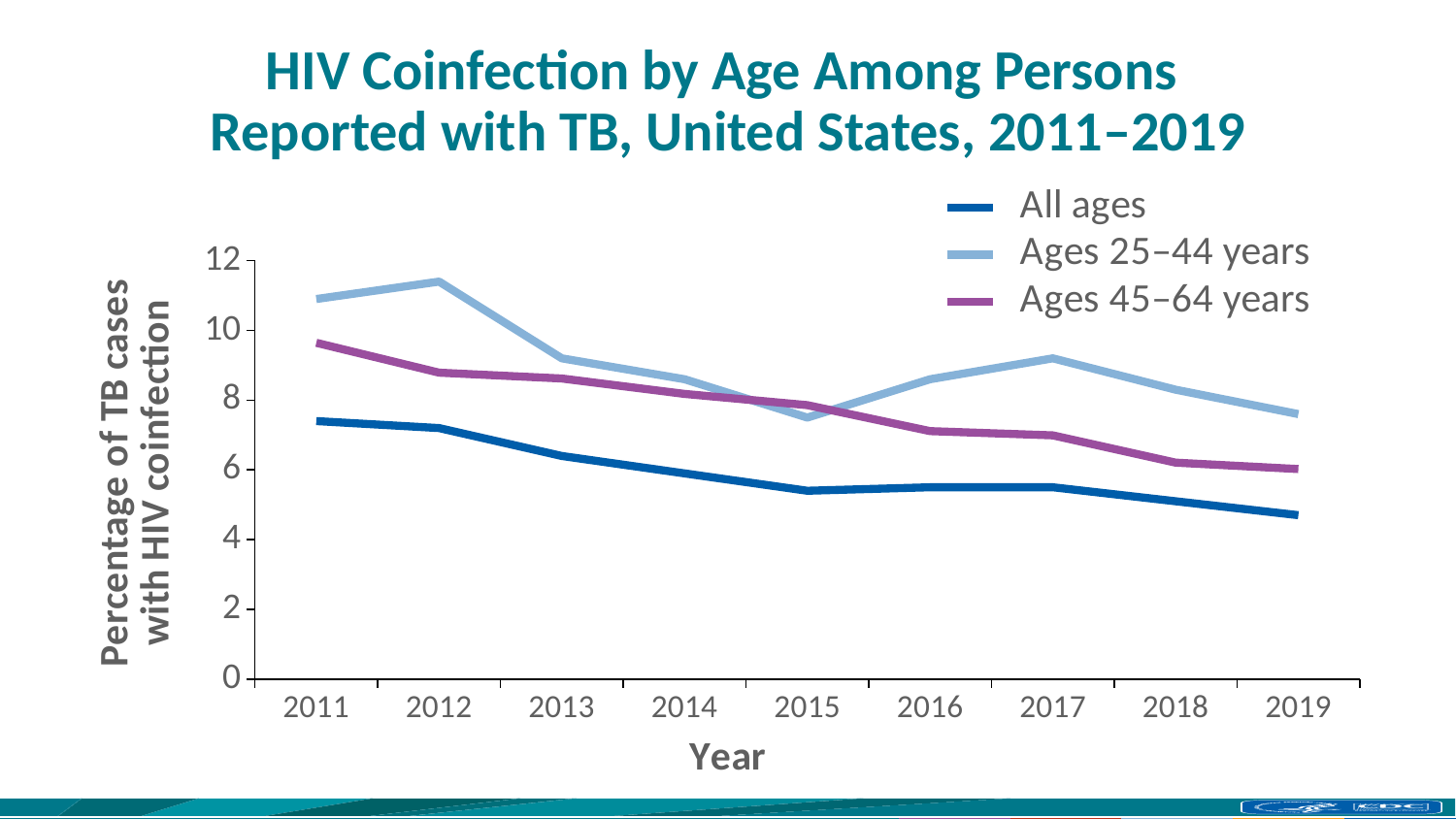
How many series does the legend list? 3 What kind of chart is shown on the slide? Line chart In 2017, which is larger: the value for Ages 25–44 years or Ages 45–64 years? Ages 25–44 years How many years are plotted along the x axis? 9 Is the value for Ages 45–64 years in 2011 greater or less than 8? greater In which year is the All ages series at its lowest? 2019 Is the value for All ages in 2011 greater or less than 6? greater Is the value for All ages in 2019 greater or less than 6? less In which year is the Ages 25–44 years series at its highest? 2012 Does the All ages series generally rise or fall from 2011 to 2019? Fall